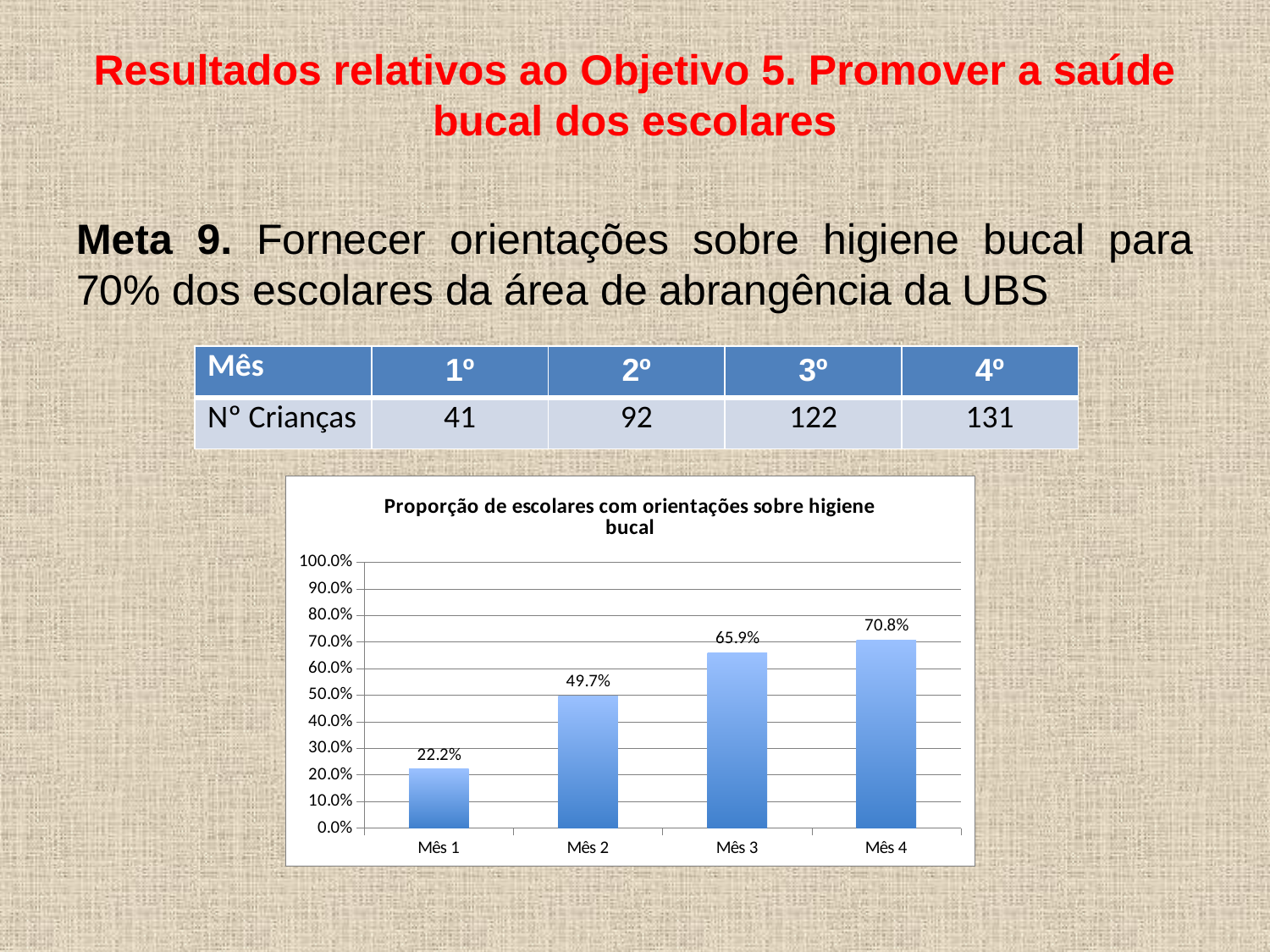
Which is larger, the value for Mês 2 or the value for Mês 3? Mês 3 Which month has the lowest value in the chart? Mês 1 What is the value for Mês 1 in the chart? 22.2% Do the values rise or fall from Mês 1 to Mês 4? Rise Which month has the highest value in the chart? Mês 4 What kind of chart is shown on the slide? Bar chart What is the difference between the values for Mês 4 and Mês 1? 48.6% How many months are shown on the x axis of the chart? 4 What is the value for Mês 3 in the chart? 65.9% What is the value for Mês 4 in the chart? 70.8% What is the difference between the values for Mês 2 and Mês 1? 27.5% What is the value for Mês 2 in the chart? 49.7%